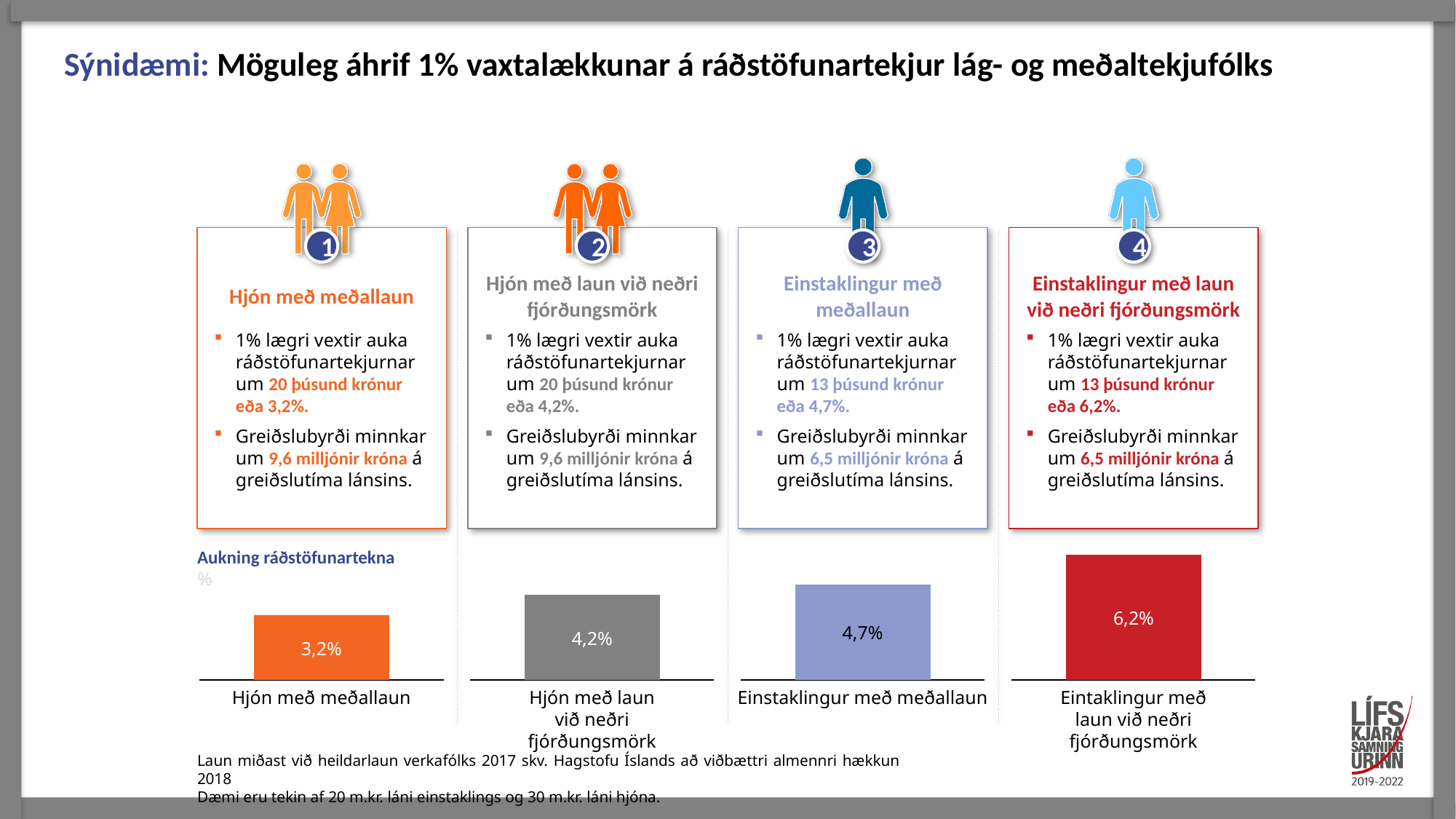
What is the value for Eintaklingur með laun við neðri fjórðungsmörk in the Aukning ráðstöfunartekna chart? 6,2% How many bars are shown in the Aukning ráðstöfunartekna chart? 4 What is the value for Hjón með meðallaun in the Aukning ráðstöfunartekna chart? 3,2% What is the value for Einstaklingur með meðallaun in the Aukning ráðstöfunartekna chart? 4,7% Do the values in the Aukning ráðstöfunartekna chart rise or fall from left to right? Rise What kind of chart is the Aukning ráðstöfunartekna chart? Bar chart What is the value for Hjón með laun við neðri fjórðungsmörk in the Aukning ráðstöfunartekna chart? 4,2% Which category has the lowest value in the Aukning ráðstöfunartekna chart? Hjón með meðallaun Which category has the highest value in the Aukning ráðstöfunartekna chart? Eintaklingur með laun við neðri fjórðungsmörk What is the difference between the values for Einstaklingur með meðallaun and Hjón með laun við neðri fjórðungsmörk in the Aukning ráðstöfunartekna chart? 0,5% What is the difference between the values for Eintaklingur með laun við neðri fjórðungsmörk and Hjón með meðallaun in the Aukning ráðstöfunartekna chart? 3,0% Which is larger in the Aukning ráðstöfunartekna chart: Hjón með laun við neðri fjórðungsmörk or Einstaklingur með meðallaun? Einstaklingur með meðallaun